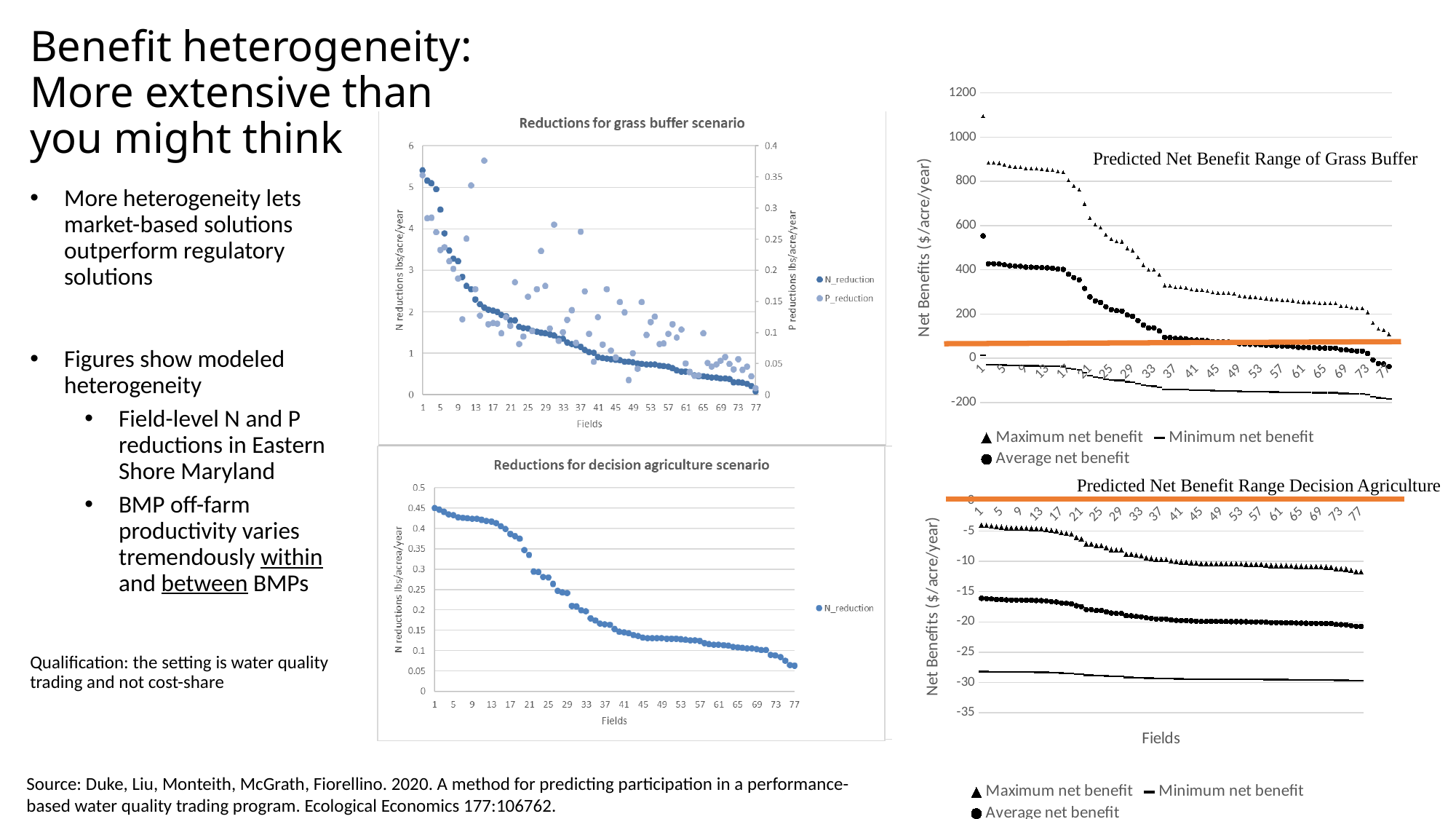
In the 'Reductions for decision agriculture scenario' chart, is the N_reduction value for field 77 greater or less than 0.1? less How many series does the legend of the 'Reductions for grass buffer scenario' chart list? 2 In the 'Reductions for grass buffer scenario' chart, is the N_reduction value for field 1 greater or less than 5? greater In the 'Predicted Net Benefit Range Decision Agriculture' chart, is the Minimum net benefit for field 1 greater or less than -35? greater How many series does the legend of the 'Predicted Net Benefit Range of Grass Buffer' chart list? 3 What is the y-axis label of the 'Predicted Net Benefit Range of Grass Buffer' chart? Net Benefits ($/acre/year) In the 'Predicted Net Benefit Range Decision Agriculture' chart, which series has the highest values: Maximum net benefit, Average net benefit, or Minimum net benefit? Maximum net benefit How many series does the legend of the 'Reductions for decision agriculture scenario' chart list? 1 In the 'Reductions for decision agriculture scenario' chart, do the N_reduction values rise or fall as the field number increases? Fall What type of chart is the 'Reductions for grass buffer scenario' chart? Scatter chart